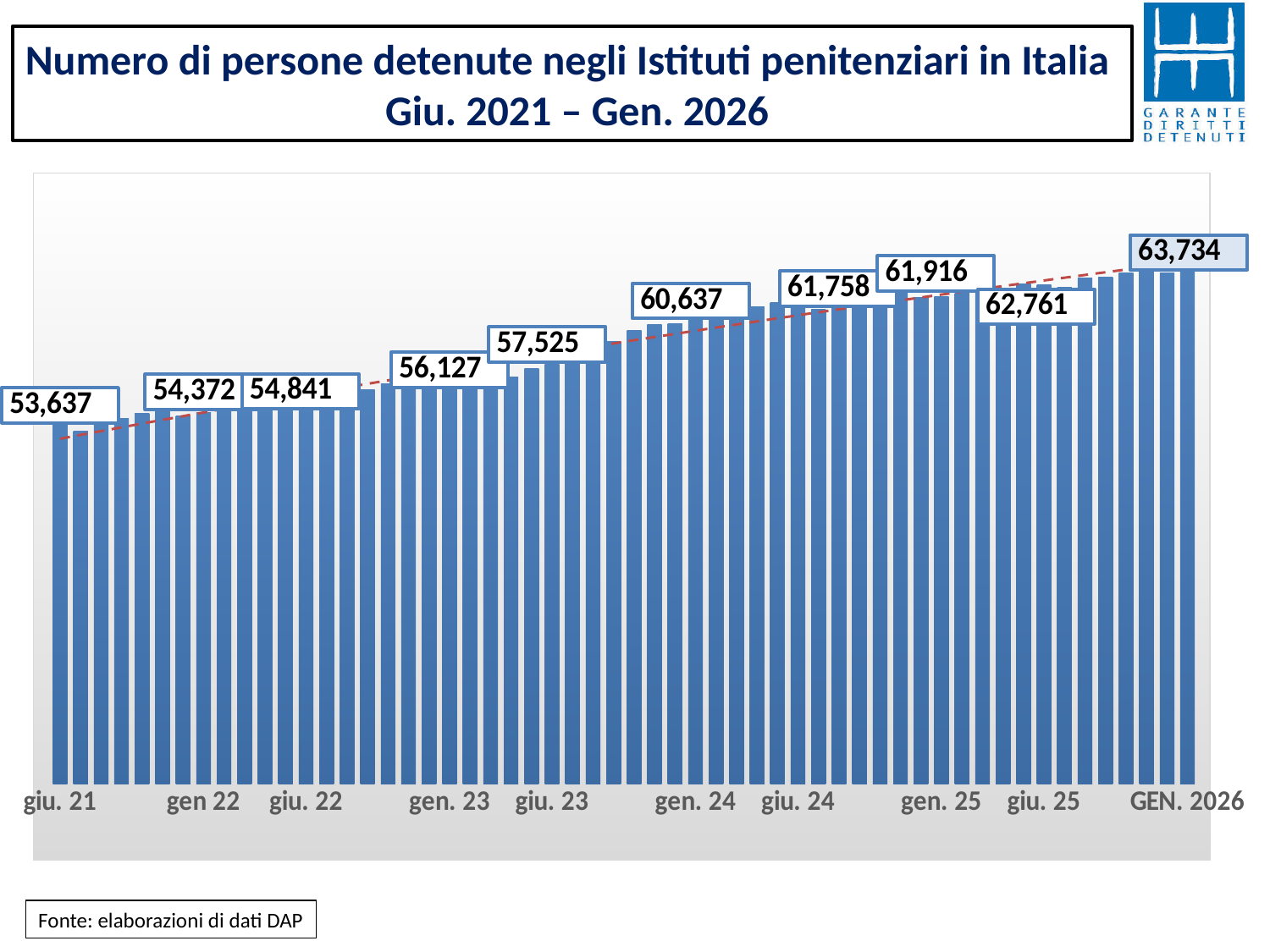
What is the value labelled for gen. 24? 60,637 What is the source stated at the bottom of the slide? Fonte: elaborazioni di dati DAP What value is labelled for GEN. 2026? 63,734 What is the value labelled for giu. 25? 62,761 Which is larger, the value for gen. 23 or the value for giu. 22? gen. 23 What is the difference between the values for GEN. 2026 and giu. 21? 10,097 Which labelled period has the highest number of detained persons? GEN. 2026 Which labelled period has the lowest number of detained persons? giu. 21 What is the difference between the values labelled for gen. 24 and giu. 23? 3,112 What is the number of detained persons shown for giu. 21? 53,637 What kind of chart is shown on the slide? Bar chart Do the values rise or fall from giu. 21 to GEN. 2026? Rise